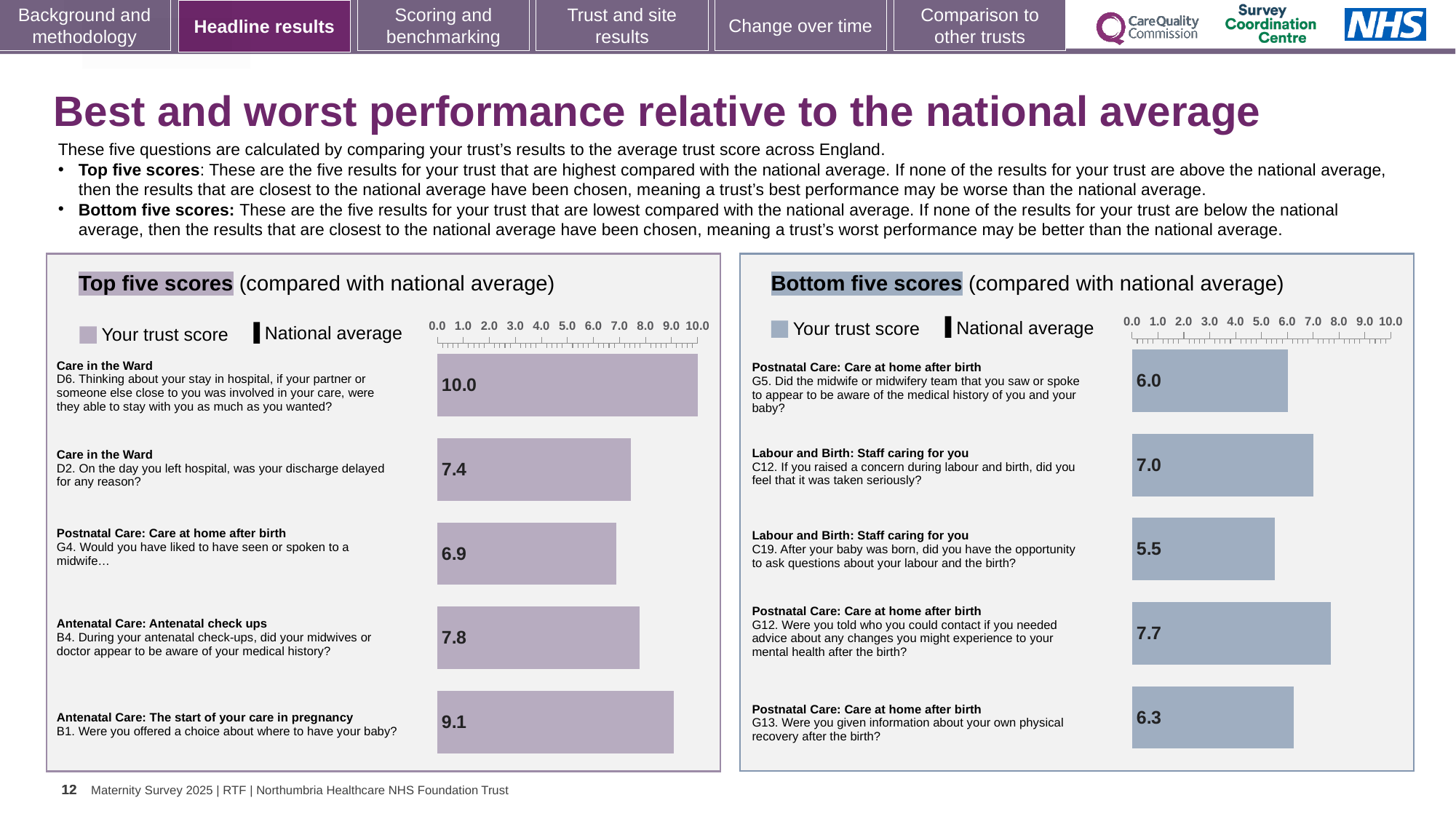
In the Bottom five scores chart, what is the trust score for G12 (told who to contact about mental health changes after the birth)? 7.7 In the Bottom five scores chart, what is the trust score for C19 (opportunity to ask questions about your labour and the birth)? 5.5 In the Top five scores chart, what is the trust score for G4 (would you have liked to have seen or spoken to a midwife)? 6.9 In the Top five scores chart, which has the larger trust score, D2 or B4? B4 In the Bottom five scores chart, which question has the highest trust score? G12 In the Bottom five scores chart, which question has the lowest trust score? C19 In the Bottom five scores chart, what is the difference between the trust scores for C12 and G5? 1.0 In the Top five scores chart, which question has the lowest trust score? G4 In the Top five scores chart, what is the trust score for D6 (partner able to stay with you as much as you wanted)? 10.0 How many bars are shown in the Bottom five scores chart? 5 What type of chart is the Top five scores chart? Bar chart In the Top five scores chart, what is the difference between the trust scores for D6 and B1? 0.9